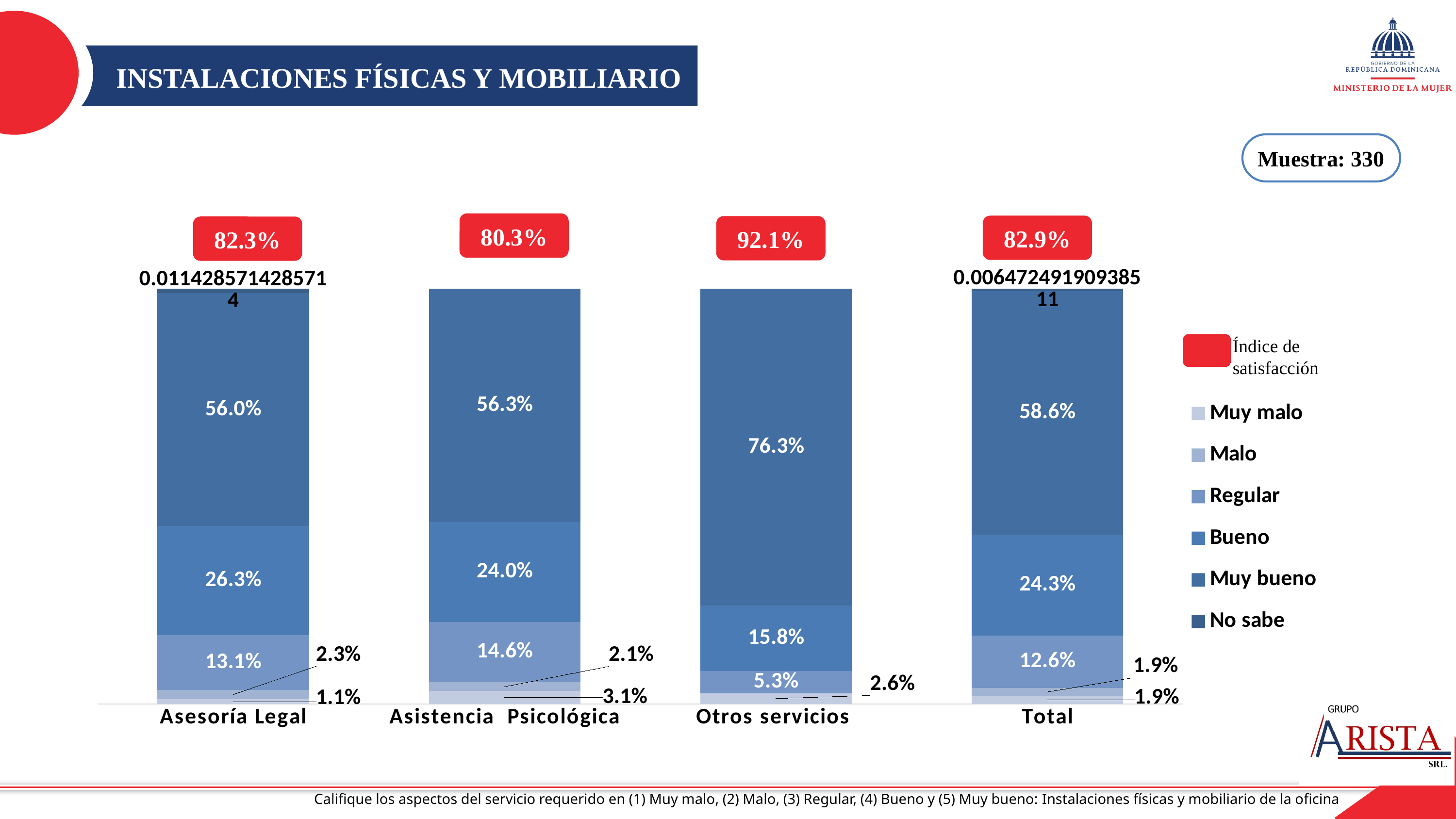
What is the Índice de satisfacción shown for Otros servicios? 92.1% What is the sample size (Muestra) shown on the slide? 330 What is the Bueno value for Asistencia Psicológica? 24.0% Which category has the highest Índice de satisfacción? Otros servicios What is the Regular value for Total? 12.6% Which category has the lowest Índice de satisfacción? Asistencia Psicológica How many series does the chart legend list (excluding the satisfaction index)? 6 How many categories are shown on the x axis of the chart? 4 What type of chart is shown on the slide? stacked bar chart What is the Muy bueno value for Otros servicios? 76.3% What is the difference between the Muy bueno values for Otros servicios and Asesoría Legal? 20.3% Which is larger, the Regular value for Asistencia Psicológica or for Asesoría Legal? Asistencia Psicológica